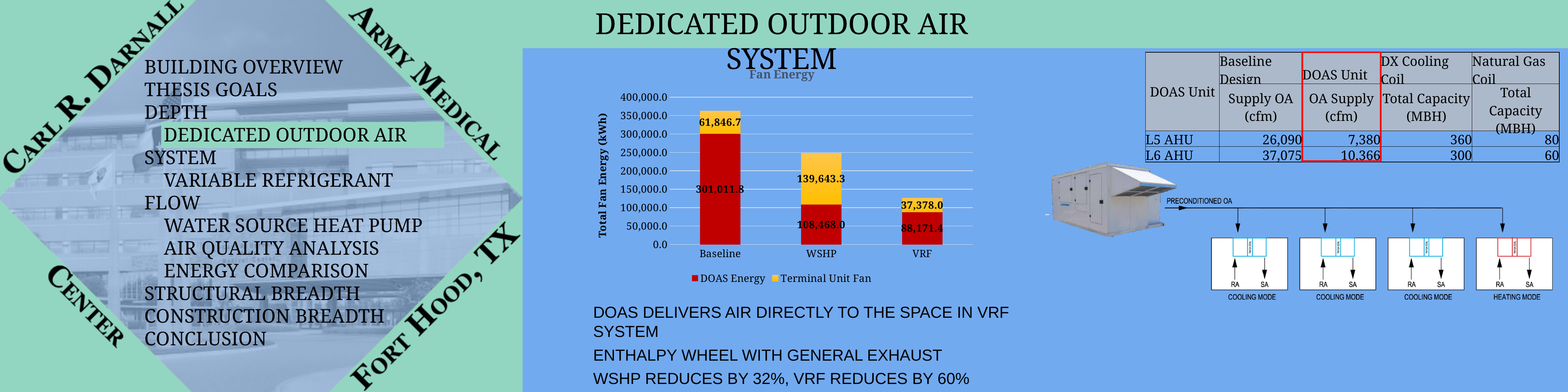
What is the DOAS Energy value for VRF in the Fan Energy chart? 88,171.4 What is the Terminal Unit Fan value for WSHP in the Fan Energy chart? 139,643.3 What type of chart is the Fan Energy chart? Stacked bar chart What is the total fan energy of the stacked bar for VRF in the Fan Energy chart? 125,549.4 How many categories are shown on the x axis of the Fan Energy chart? 3 What is the DOAS Energy value for Baseline in the Fan Energy chart? 301,011.8 How many series does the legend of the Fan Energy chart list? 2 What is the difference between the DOAS Energy values for Baseline and WSHP in the Fan Energy chart? 192,543.8 In the Fan Energy chart, is the Terminal Unit Fan value larger for WSHP or for VRF? WSHP Which category has the highest DOAS Energy value in the Fan Energy chart? Baseline What is the Terminal Unit Fan value for Baseline in the Fan Energy chart? 61,846.7 Which category has the lowest Terminal Unit Fan value in the Fan Energy chart? VRF